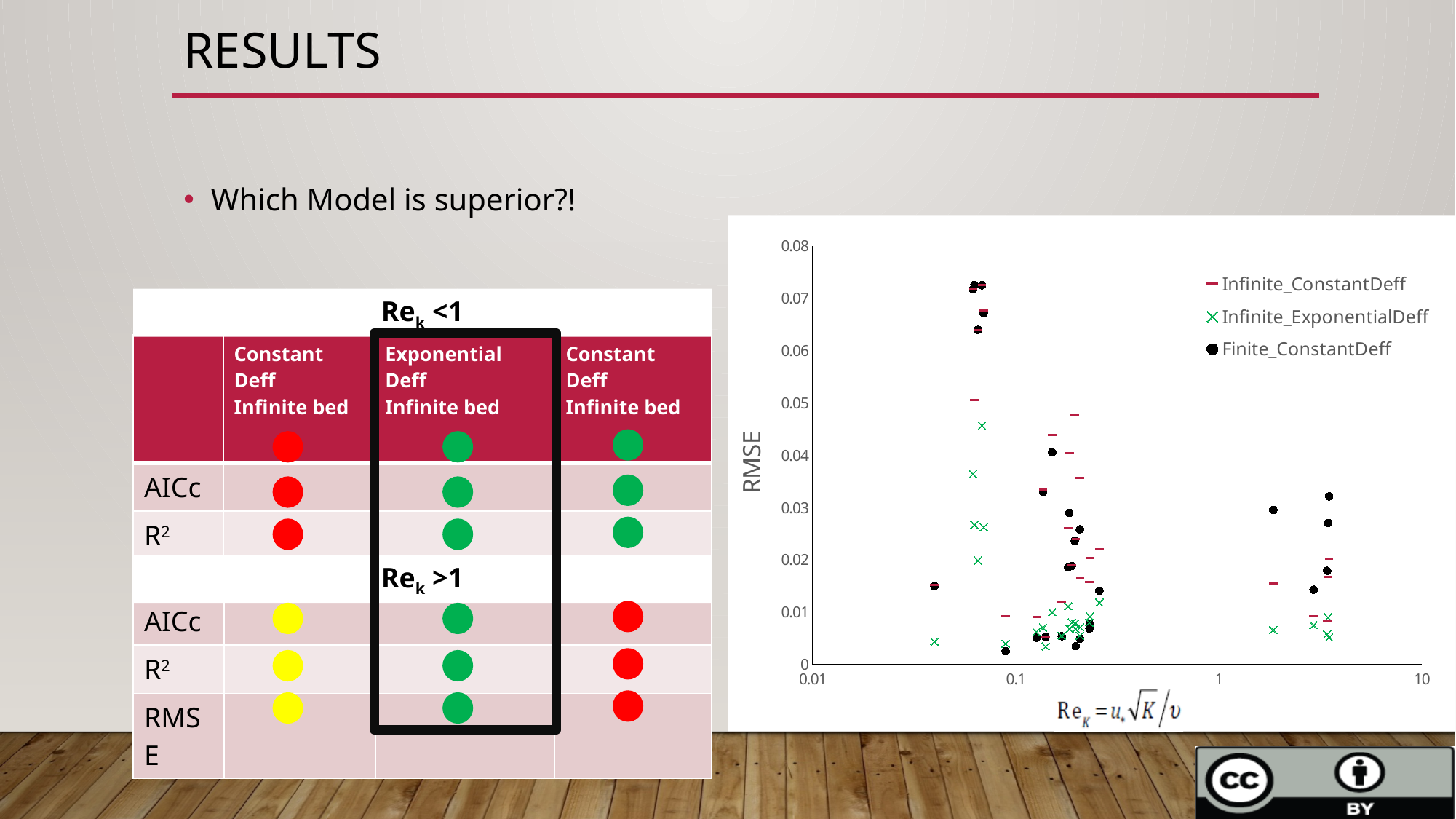
What kind of chart is shown on the right of the slide? scatter chart What are the three series named in the legend of the RMSE chart? Infinite_ConstantDeff, Infinite_ExponentialDeff, Finite_ConstantDeff Which series on the scatter chart has the lowest maximum RMSE value? Infinite_ExponentialDeff Is the highest Finite_ConstantDeff point plotted near Re_K = 3 greater or less than 0.04 RMSE? less Is the highest Infinite_ConstantDeff point plotted near Re_K = 0.3 greater or less than 0.06 RMSE? less How many series does the legend of the RMSE chart list? 3 Is the highest RMSE value plotted on the scatter chart greater or less than 0.07? greater What is the label on the vertical axis of the scatter chart? RMSE